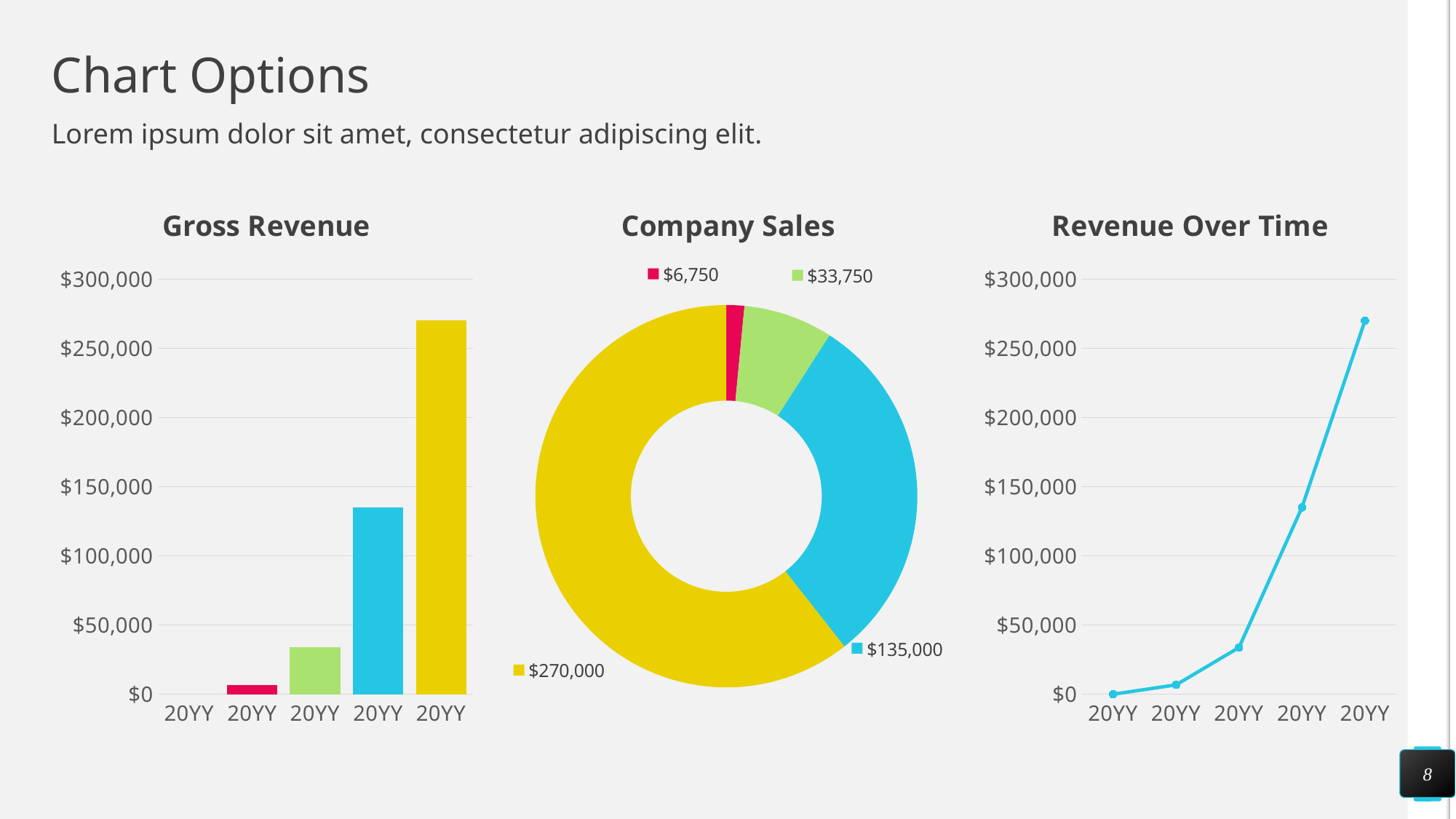
In the Company Sales chart, what is the difference between the $270,000 slice and the $135,000 slice? $135,000 In the Company Sales chart, what is the total of all four slices? $445,500 In the Revenue Over Time chart, is the value of the last point greater or less than $250,000? greater How many bars does the Gross Revenue chart have? 4 In the Gross Revenue chart, is the value of the rightmost bar greater or less than $250,000? greater What kind of chart is the Gross Revenue chart? bar chart In the Company Sales chart, what is the value of the smallest slice? $6,750 In the Gross Revenue chart, is the value of the fourth bar from the left greater or less than $150,000? less What kind of chart is the Revenue Over Time chart? line chart What kind of chart is the Company Sales chart? doughnut chart In the Company Sales chart, what is the value of the largest slice? $270,000 In the Gross Revenue chart, do the bar values rise or fall from left to right? rise